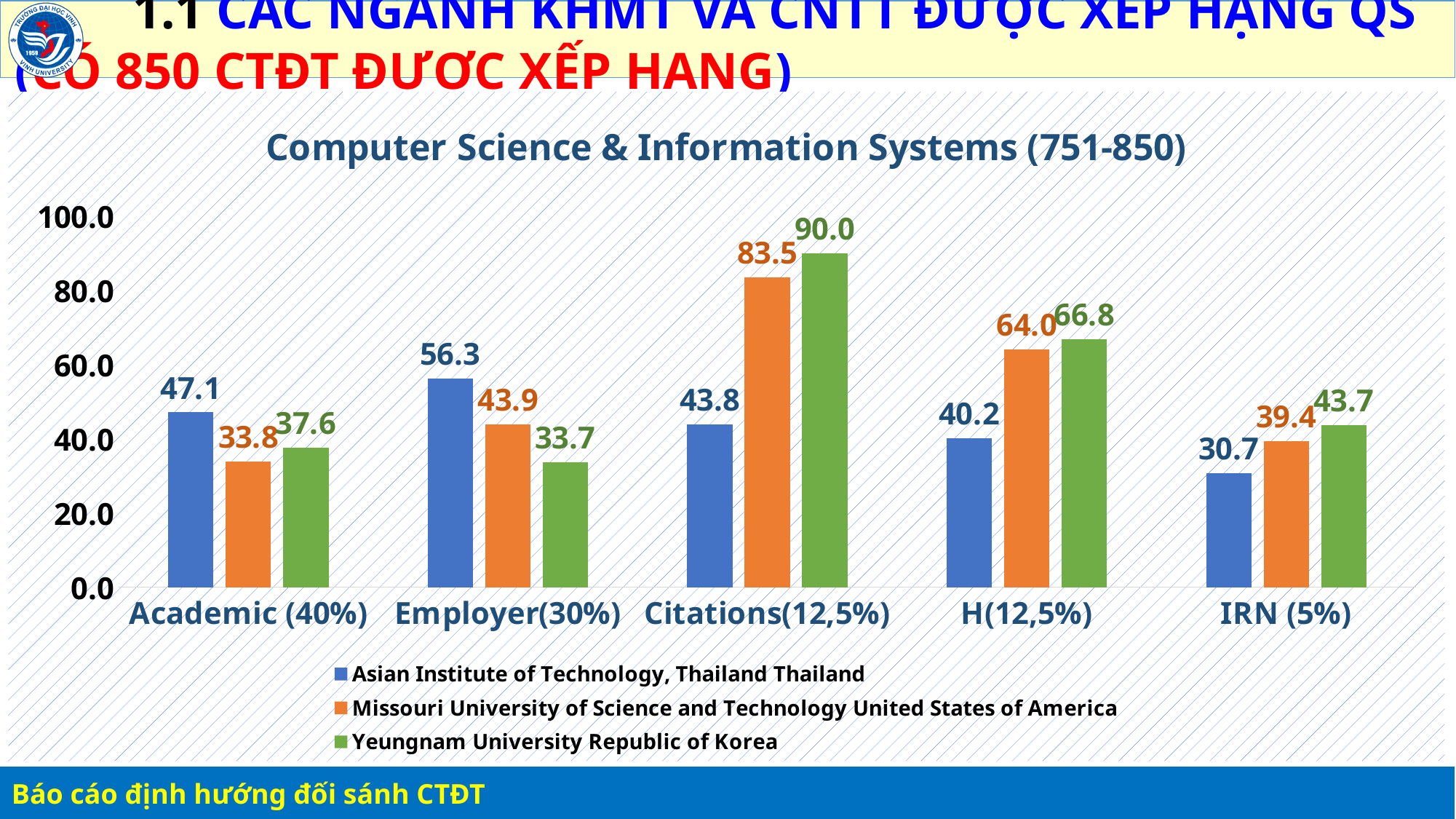
What is the value for Asian Institute of Technology, Thailand in the Academic (40%) category? 47.1 What is the value for Yeungnam University Republic of Korea in the Citations(12,5%) category? 90.0 In which category does Asian Institute of Technology, Thailand have its highest value? Employer(30%) How many series does the legend list? 3 What is the value for Missouri University of Science and Technology in the H(12,5%) category? 64.0 What is the title of the chart? Computer Science & Information Systems (751-850) What is the difference between Yeungnam University and Missouri University of Science and Technology in the Citations(12,5%) category? 6.5 In the Employer(30%) category, which is larger: Asian Institute of Technology, Thailand or Yeungnam University Republic of Korea? Asian Institute of Technology, Thailand Is the value for Missouri University of Science and Technology in the Citations(12,5%) category greater or less than 80.0? greater How many categories are shown on the x axis? 5 In which category does Asian Institute of Technology, Thailand have its lowest value? IRN (5%) What kind of chart is shown on the slide? bar chart